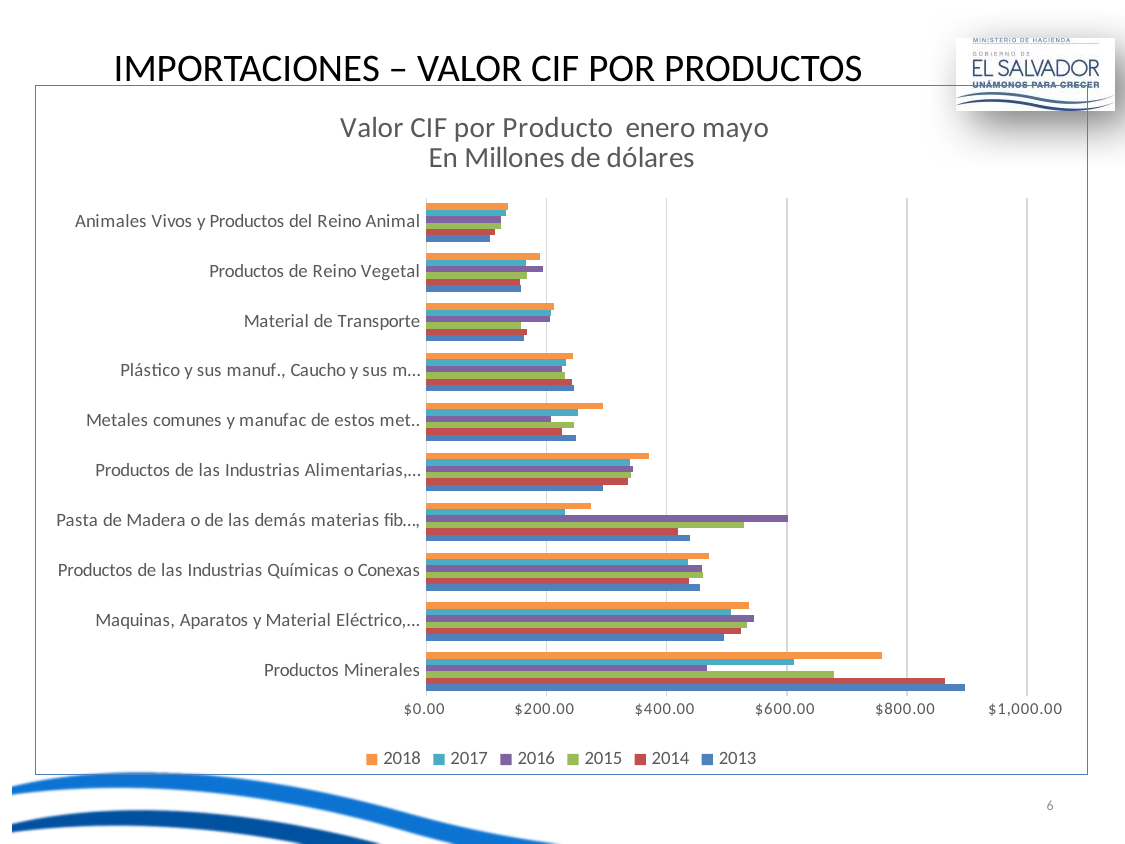
For Productos Minerales, which year has the larger value, 2013 or 2018? 2013 For Pasta de Madera o de las demás materias fib..., which year has the larger value, 2016 or 2018? 2016 Is the 2018 value for Animales Vivos y Productos del Reino Animal greater or less than $200.00? less Is the 2018 value for Metales comunes y manufac de estos met.. greater or less than $400.00? less Which product category has the highest import values on the chart? Productos Minerales How many series does the legend list? 6 How many product categories are plotted on the chart? 10 Is the 2013 value for Productos Minerales greater or less than $800.00? greater What kind of chart is shown on the slide? Bar chart Which product category has the lowest import values on the chart? Animales Vivos y Productos del Reino Animal What is the title of the chart? Valor CIF por Producto enero mayo En Millones de dólares